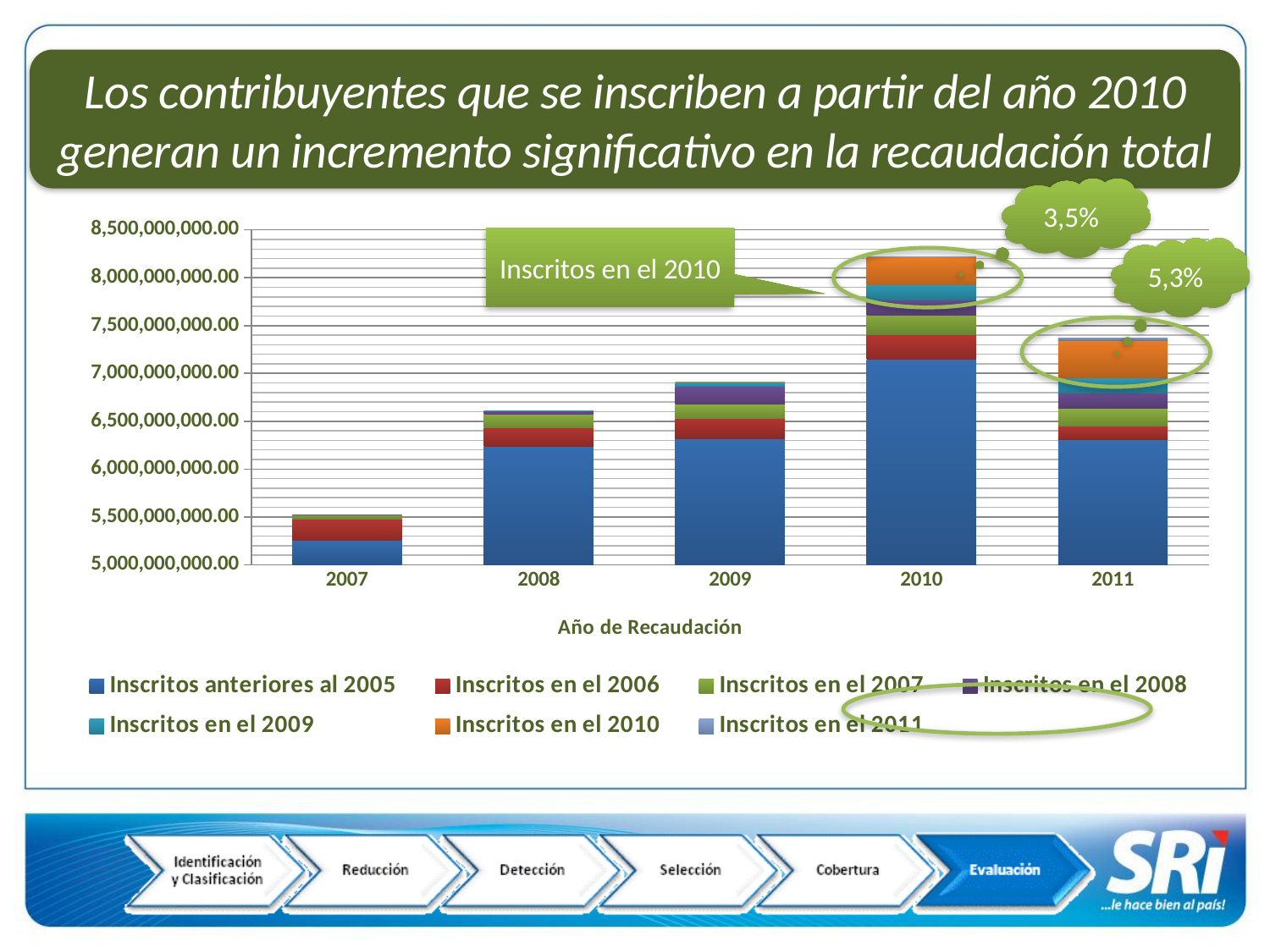
How many series does the chart legend list? 7 Which year has the shortest stacked bar? 2007 How many years are shown on the x axis of the chart? 5 Is the total for 2007 greater or less than 6,000,000,000.00? less Which year has the larger total, 2010 or 2011? 2010 Which year has the larger total, 2008 or 2009? 2009 What is the title of the x axis of the chart? Año de Recaudación Does the total collection rise or fall from 2007 to 2010? rise What kind of chart is shown on the slide? Stacked bar chart Which year has the tallest stacked bar? 2010 Is the total for 2011 greater or less than 7,000,000,000.00? greater Is the total for 2010 greater or less than 8,000,000,000.00? greater